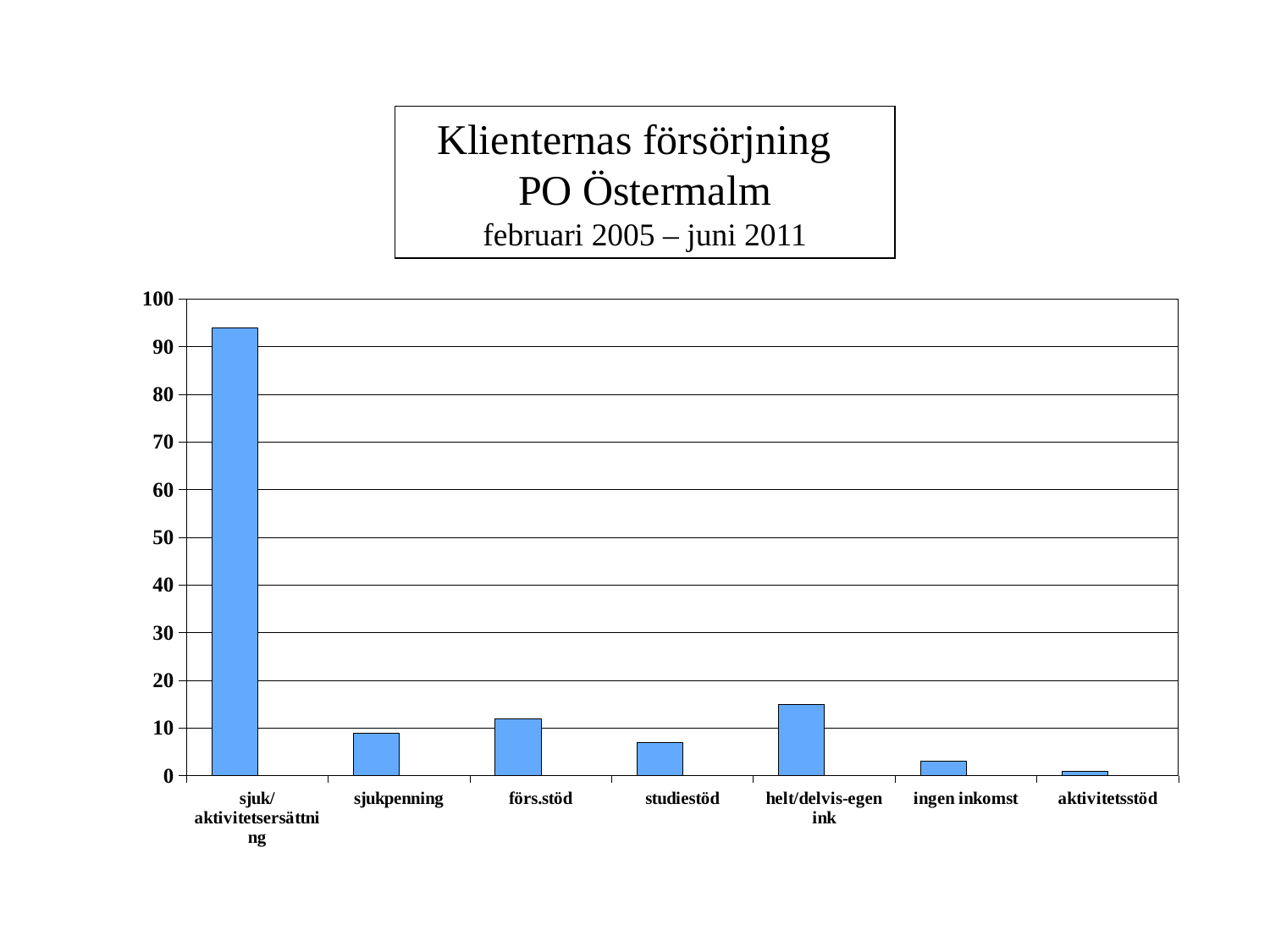
Is the value for förs.stöd greater or less than 10? greater Which category has the lowest bar in the chart? aktivitetsstöd How many categories are shown on the x axis of the chart? 7 What period does the chart title say the data covers? februari 2005 – juni 2011 Is the value for helt/delvis-egen ink greater or less than 20? less Which is larger, the value for förs.stöd or the value for sjukpenning? förs.stöd Which is larger, the value for helt/delvis-egen ink or the value for förs.stöd? helt/delvis-egen ink Is the value for sjuk/aktivitetsersättning greater or less than 90? greater Which category has the highest bar in the chart? sjuk/aktivitetsersättning What kind of chart is shown on the slide? bar chart